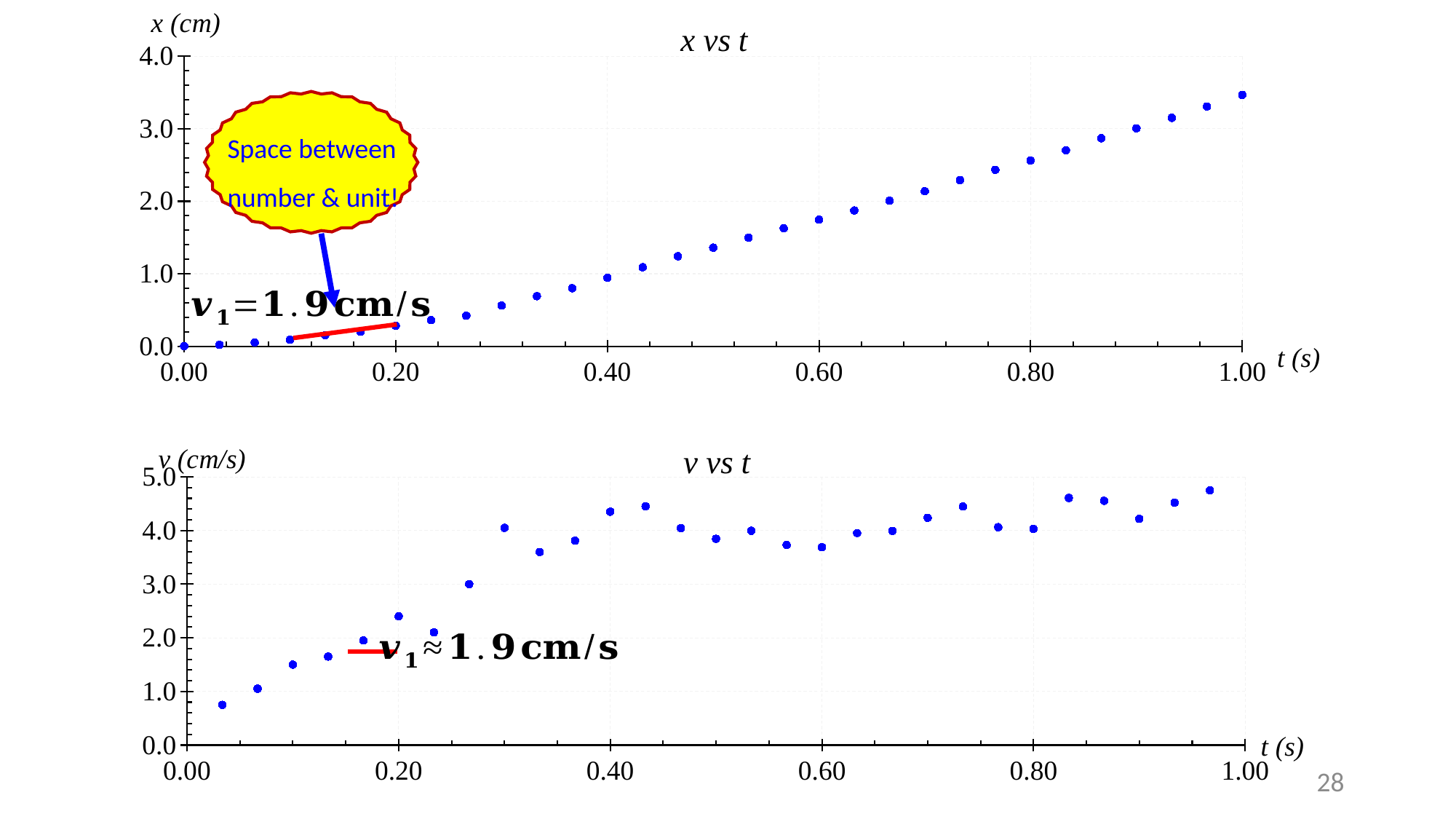
What kind of chart is the "v vs t" chart? scatter plot What kind of chart is the "x vs t" chart? scatter plot In the "x vs t" chart, what is the value of x at t = 0.00 s? 0.0 What is the label of the vertical axis of the "v vs t" chart? v (cm/s) In the "v vs t" chart, which is larger: v at t = 0.20 s or v at t = 0.40 s? v at t = 0.40 s In the "x vs t" chart, do the values rise or fall as t increases? rise What value of v1 is annotated on the "x vs t" chart? 1.9 cm/s In the "v vs t" chart, is the value of v at t = 0.60 s greater or less than 4.0? less In the "x vs t" chart, is the value of x at t = 1.00 s greater or less than 3.0? greater In the "x vs t" chart, at which value of t is x highest? 1.00 In the "v vs t" chart, is the value of v at t = 0.20 s greater or less than 2.0? greater